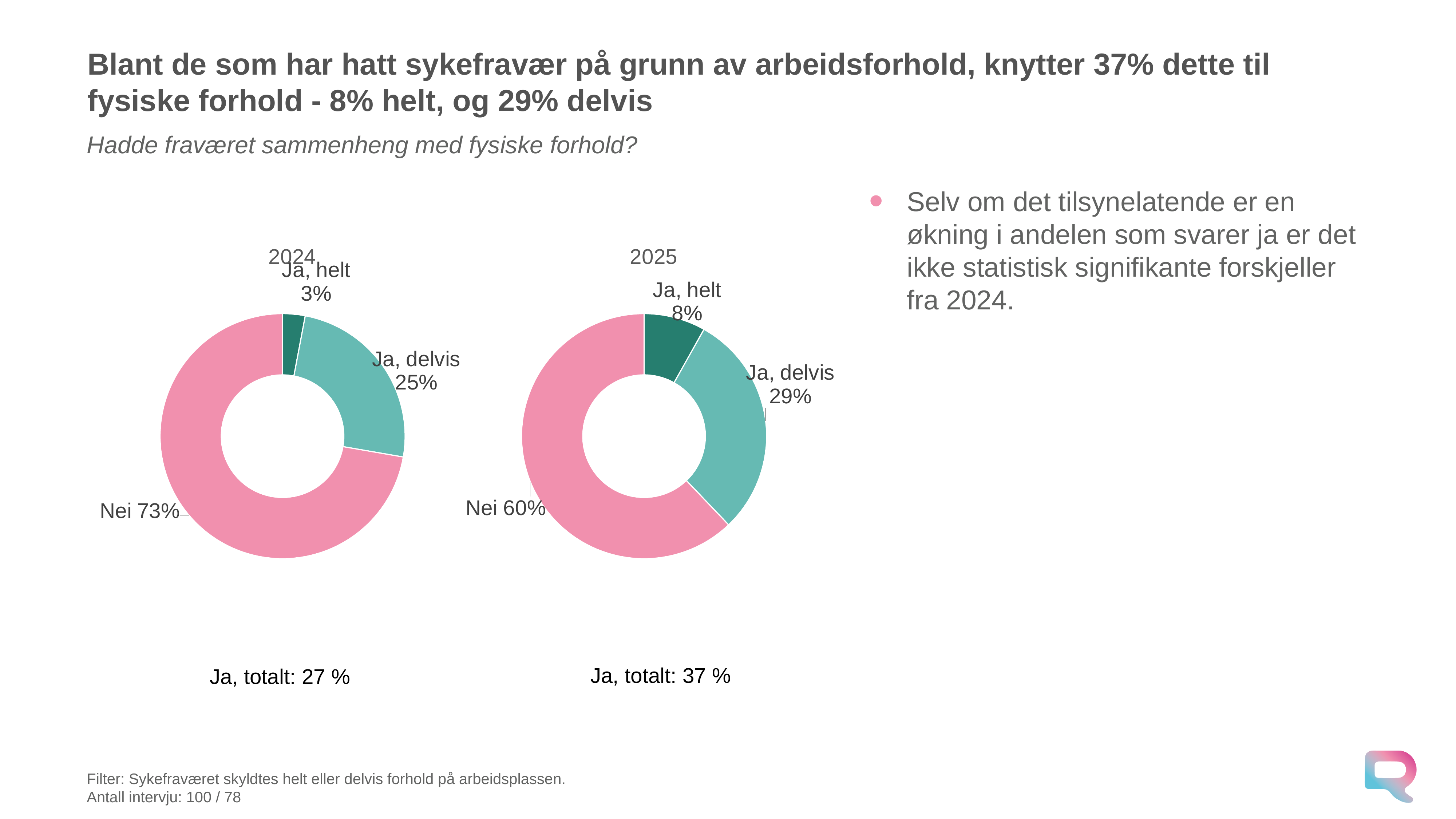
Which is larger: "Ja, delvis" in the 2024 chart or "Ja, delvis" in the 2025 chart? 2025 In the 2024 chart, which category has the smallest share? Ja, helt In the 2025 chart, what is the combined share of "Ja, helt" and "Ja, delvis"? 37% What kind of chart is the 2024 chart? Donut (pie) chart In the 2025 chart, what is the value for "Ja, helt"? 8% In the 2025 chart, what is the value for "Ja, delvis"? 29% What is the difference between the "Nei" share in the 2024 chart and the "Nei" share in the 2025 chart? 13 percentage points How many categories does the 2025 chart show? 3 In the 2024 chart, what colour is the "Nei" segment? Pink In the 2024 chart, what is the value for "Ja, helt"? 3% In the 2025 chart, which category has the largest share? Nei In the 2024 chart, what is the value for "Nei"? 73%